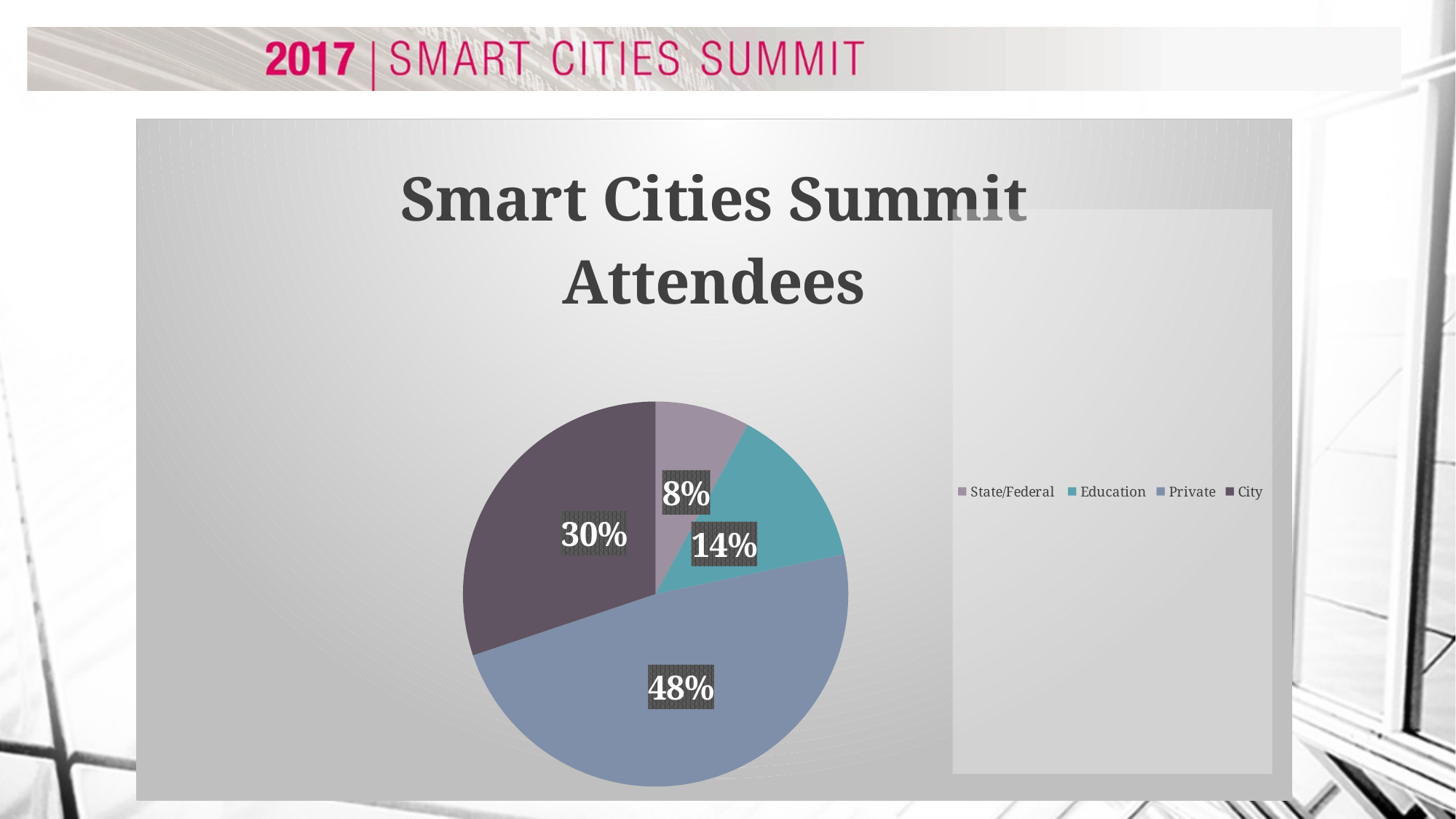
Which category has the largest share of attendees? Private What is the title of the chart? Smart Cities Summit Attendees What kind of chart is shown on the slide? pie chart How many categories does the pie chart show? 4 What share of attendees is Private? 48% What share of attendees is Education? 14% What share of attendees is State/Federal? 8% Which is larger, the share for City or the share for Education? City What share of attendees is City? 30% How many entries does the legend list? 4 Which category has the smallest share of attendees? State/Federal What is the difference in percentage points between the Private share and the City share? 18